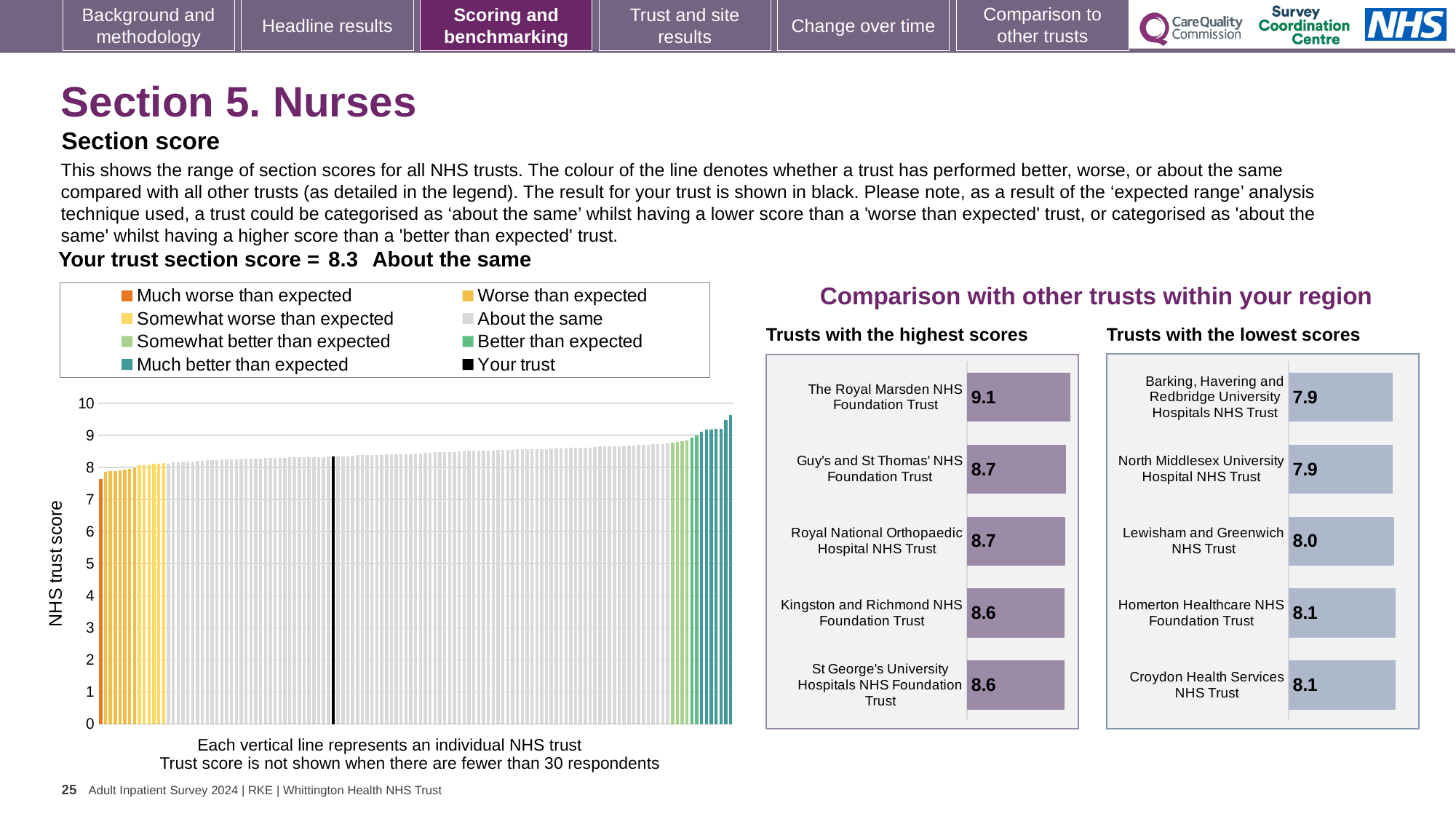
In the 'Trusts with the highest scores' chart, which trust has the highest score? The Royal Marsden NHS Foundation Trust In the 'Trusts with the lowest scores' chart, what is the score for Lewisham and Greenwich NHS Trust? 8.0 In the 'Trusts with the highest scores' chart, how many trusts are listed? 5 In the main 'NHS trust score' chart on the left, do the trust scores rise or fall from left to right? rise In the 'Trusts with the lowest scores' chart, which has the larger score: Lewisham and Greenwich NHS Trust or Homerton Healthcare NHS Foundation Trust? Homerton Healthcare NHS Foundation Trust Comparing the two right-hand charts, what is the difference between the score of The Royal Marsden NHS Foundation Trust and the score of Barking, Havering and Redbridge University Hospitals NHS Trust? 1.2 In the 'Trusts with the highest scores' chart, what is the difference between the scores of The Royal Marsden NHS Foundation Trust and Kingston and Richmond NHS Foundation Trust? 0.5 In the main 'NHS trust score' chart on the left, is the value for your trust (the black line) greater or less than 8? greater In the 'Trusts with the highest scores' chart, what is the score for The Royal Marsden NHS Foundation Trust? 9.1 In the 'Trusts with the lowest scores' chart, how many trusts are listed? 5 What kind of chart is the 'Trusts with the lowest scores' chart? bar chart How many entries does the legend of the main 'NHS trust score' chart list? 8